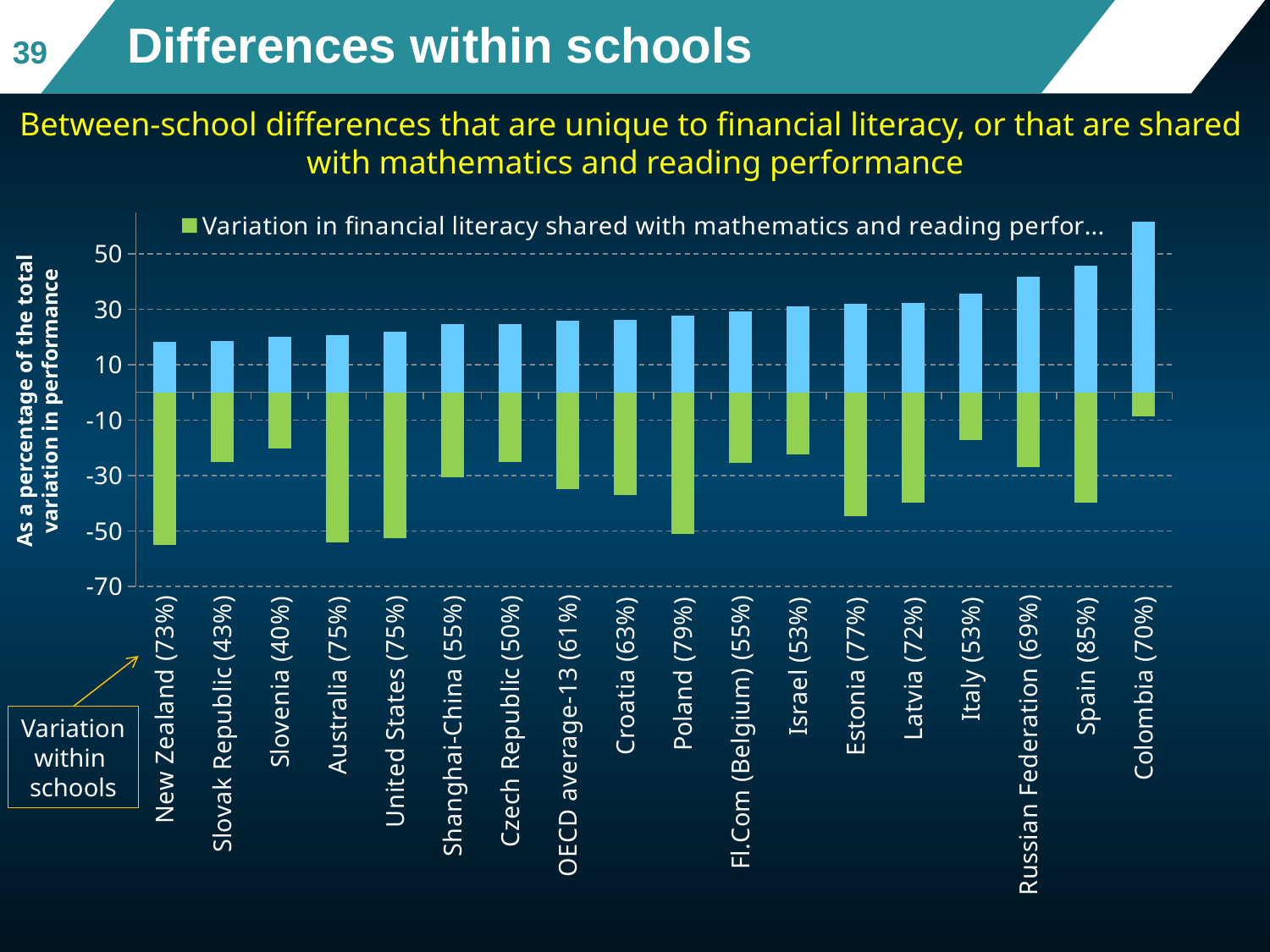
Is the green bar value for Italy greater or less than -30? greater Is the green bar value for Croatia greater or less than -30? less Is the blue bar value for New Zealand greater or less than 30? less Do the blue bars generally rise or fall from left to right along the x axis? rise How many countries/economies are shown along the x axis of the chart? 18 Which has the larger blue bar, Spain or Italy? Spain What kind of chart is shown on the slide? bar chart Which country has the shortest green bar (smallest negative value)? Colombia What percentage is shown in parentheses next to Spain on the x axis? 85%